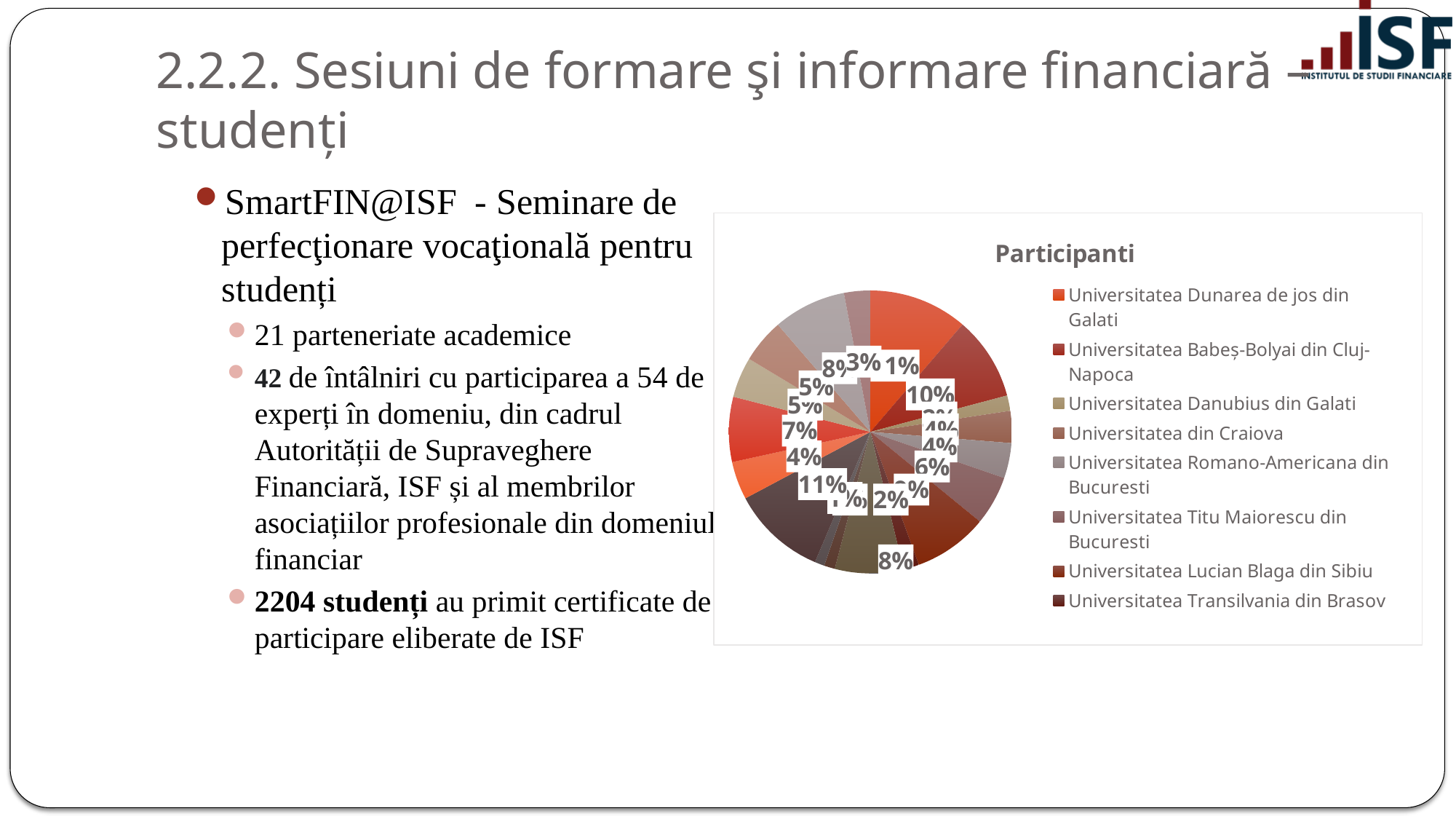
What is the smallest percentage label shown on any slice of the pie chart? 1% What kind of chart is shown on the slide? pie chart What is the title of the chart? Participanti How many entries does the chart's legend list? 8 Which university is listed first in the chart's legend? Universitatea Dunarea de jos din Galati What is the largest percentage label shown on any slice of the pie chart? 11%